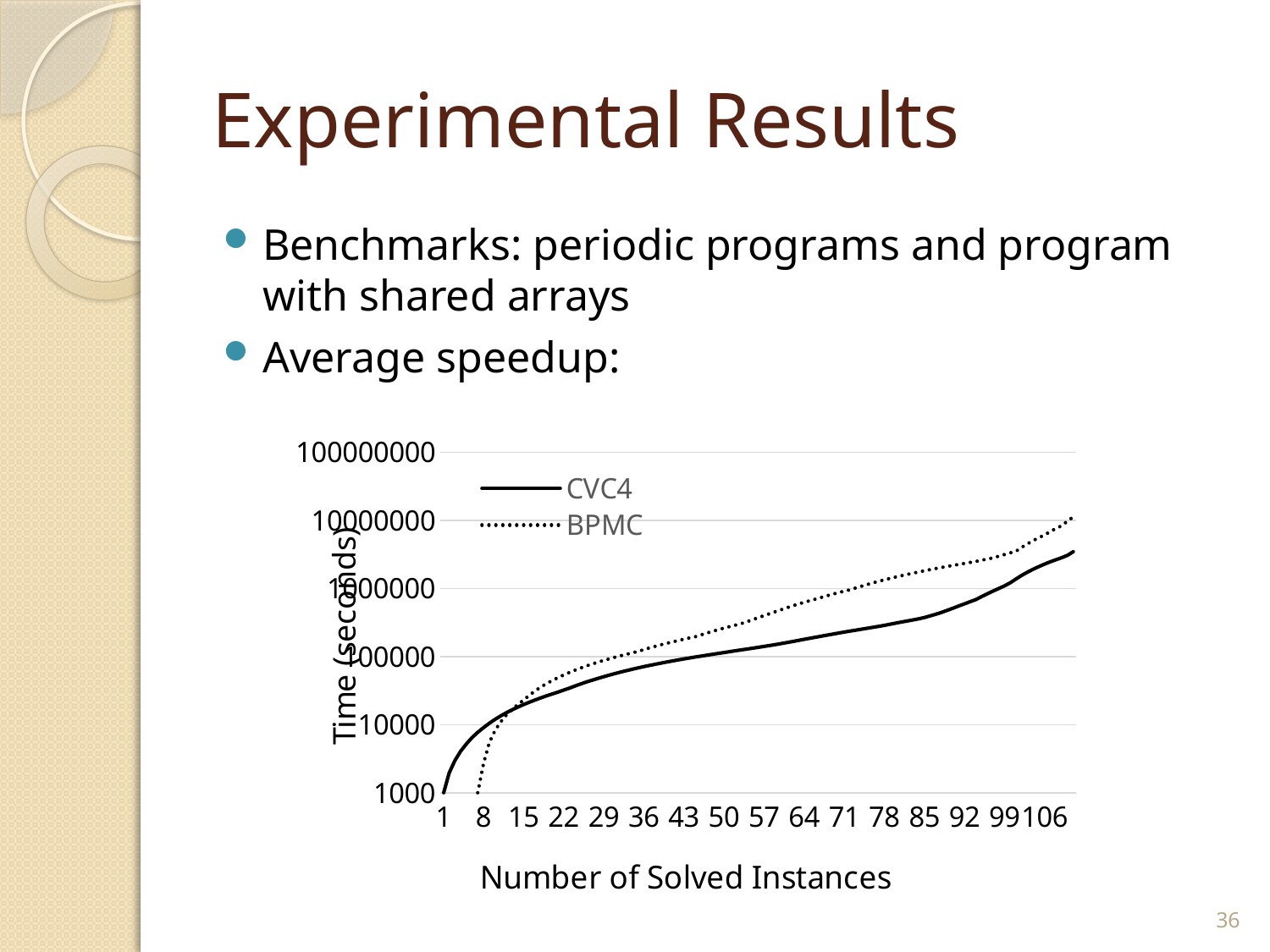
How many series does the legend list? 2 Is the BPMC time at 50 solved instances greater or less than 100000? greater How many tick labels are shown on the x axis? 16 What kind of chart is shown on the slide? line chart What is the title of the x axis? Number of Solved Instances Is the CVC4 time at 1 solved instance greater or less than 10000? less At 8 solved instances, which series shows the lower time? BPMC What are the two series named in the legend? CVC4 and BPMC At 106 solved instances, which series shows the higher time? BPMC Is the CVC4 time at 106 solved instances greater or less than 1000000? greater Does the BPMC line rise or fall as the number of solved instances increases? rise Does the CVC4 line rise or fall as the number of solved instances increases? rise